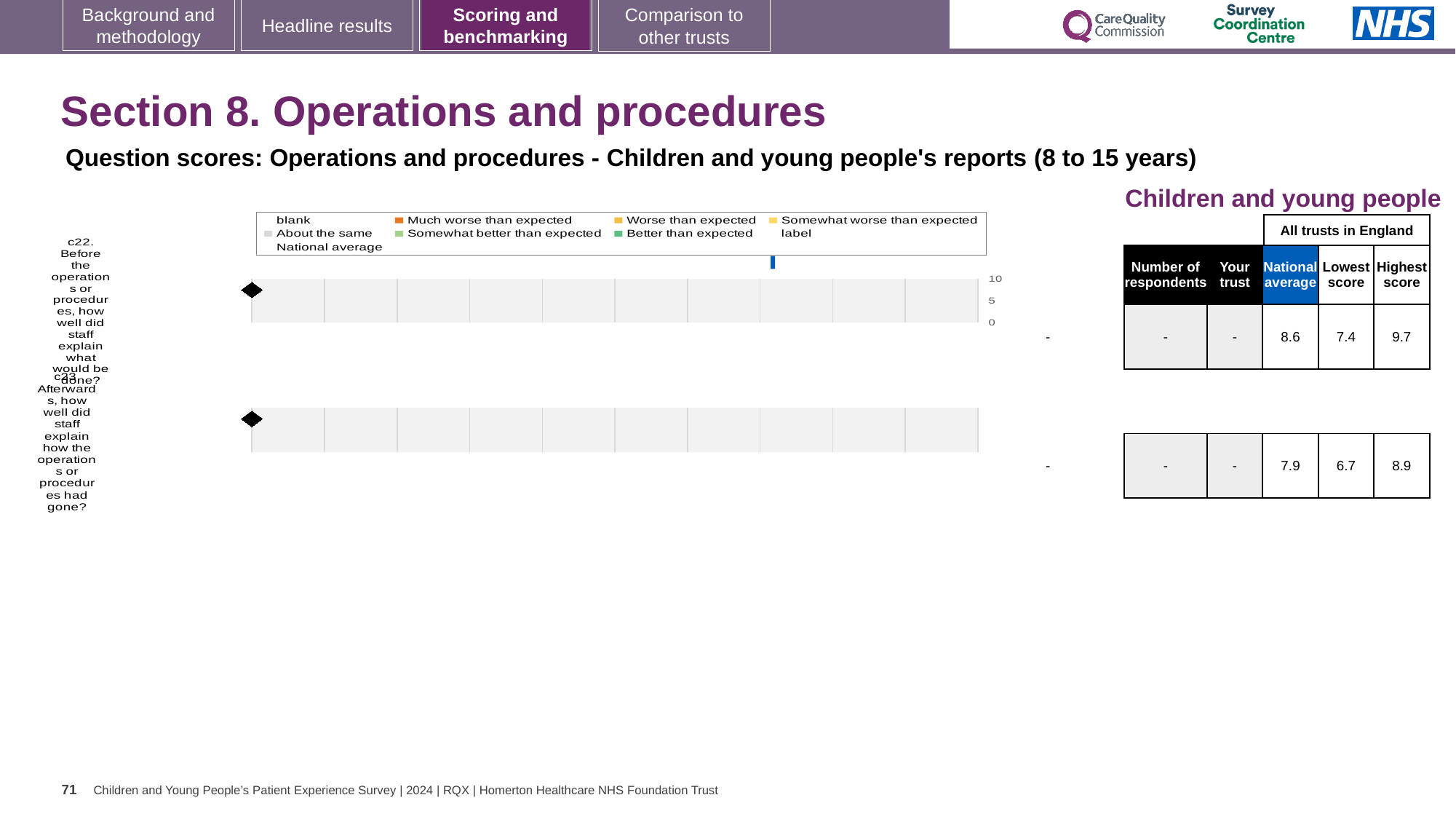
What is the difference between the Highest score and the Lowest score for question c23 in the table? 2.2 What is the highest tick value shown on the chart's value axis? 10 Which question has the higher National average score in the table, c22 or c23? c22 How many survey questions are listed as categories on the chart? 2 In the table beside the chart, what is the National average score for question c22 (Before the operations or procedures, how well did staff explain what would be done?)? 8.6 In the table beside the chart, what is the Lowest score for question c23 (Afterwards, how well did staff explain how the operations or procedures had gone?)? 6.7 What is the difference between the Highest score and the Lowest score for question c22 in the table? 2.3 What colour does the legend use for "Much worse than expected"? orange In the table beside the chart, what is the Highest score for question c22? 9.7 Which question has the lower Highest score in the table, c22 or c23? c23 In the table beside the chart, what is the Your trust score shown for question c22? - What kind of chart is shown on the slide? bar chart